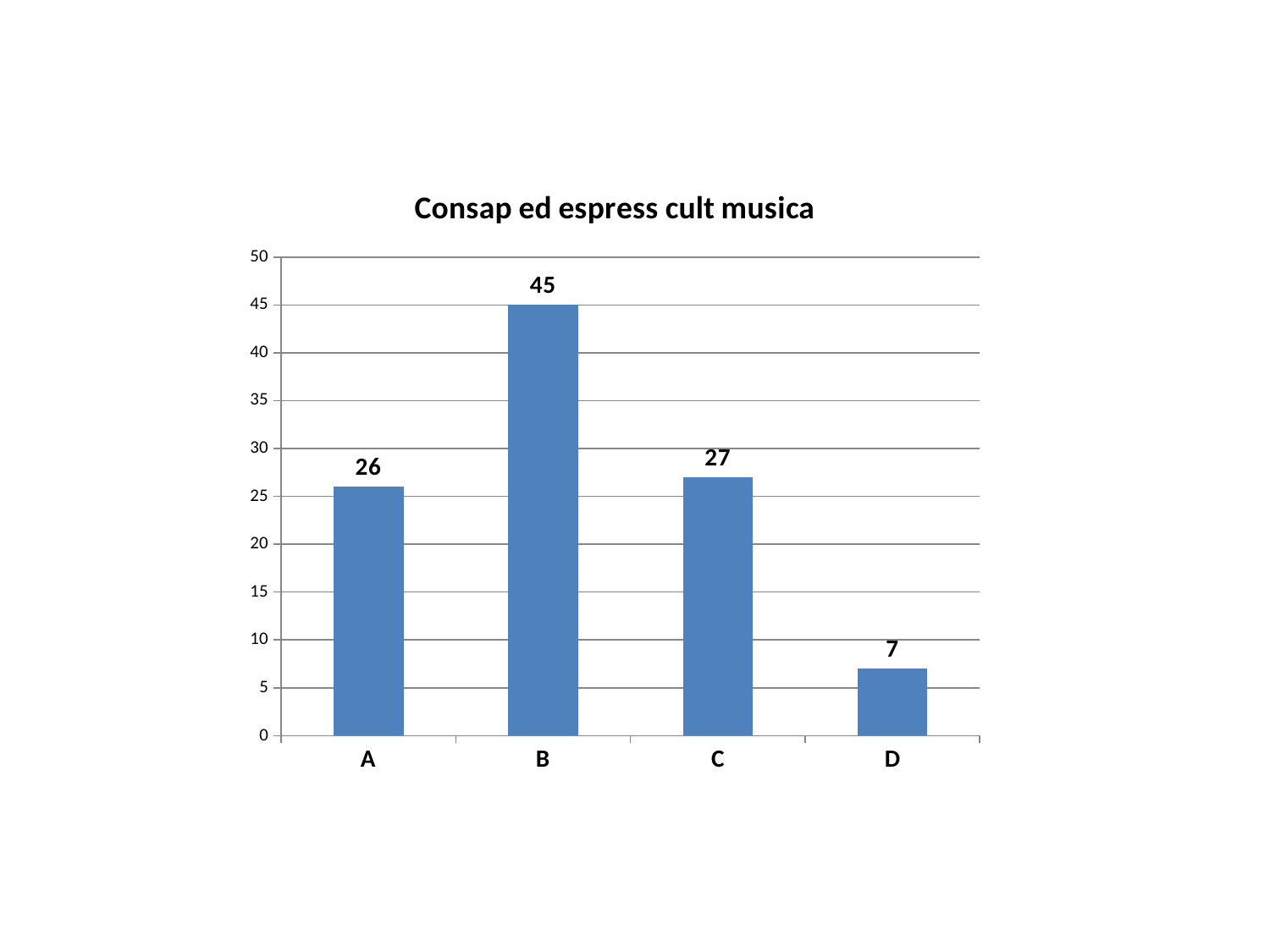
How many categories are shown on the x axis? 4 Which category has the highest value? B Which category has the lowest value? D What is the title of the chart? Consap ed espress cult musica Which is larger, the value for B or the value for A? B What is the difference between the values for B and C? 18 What is the value for category B? 45 What is the value for category A? 26 What is the value for category D? 7 What is the difference between the values for A and D? 19 What kind of chart is shown on the slide? bar chart Is the value for C greater or less than 30? less